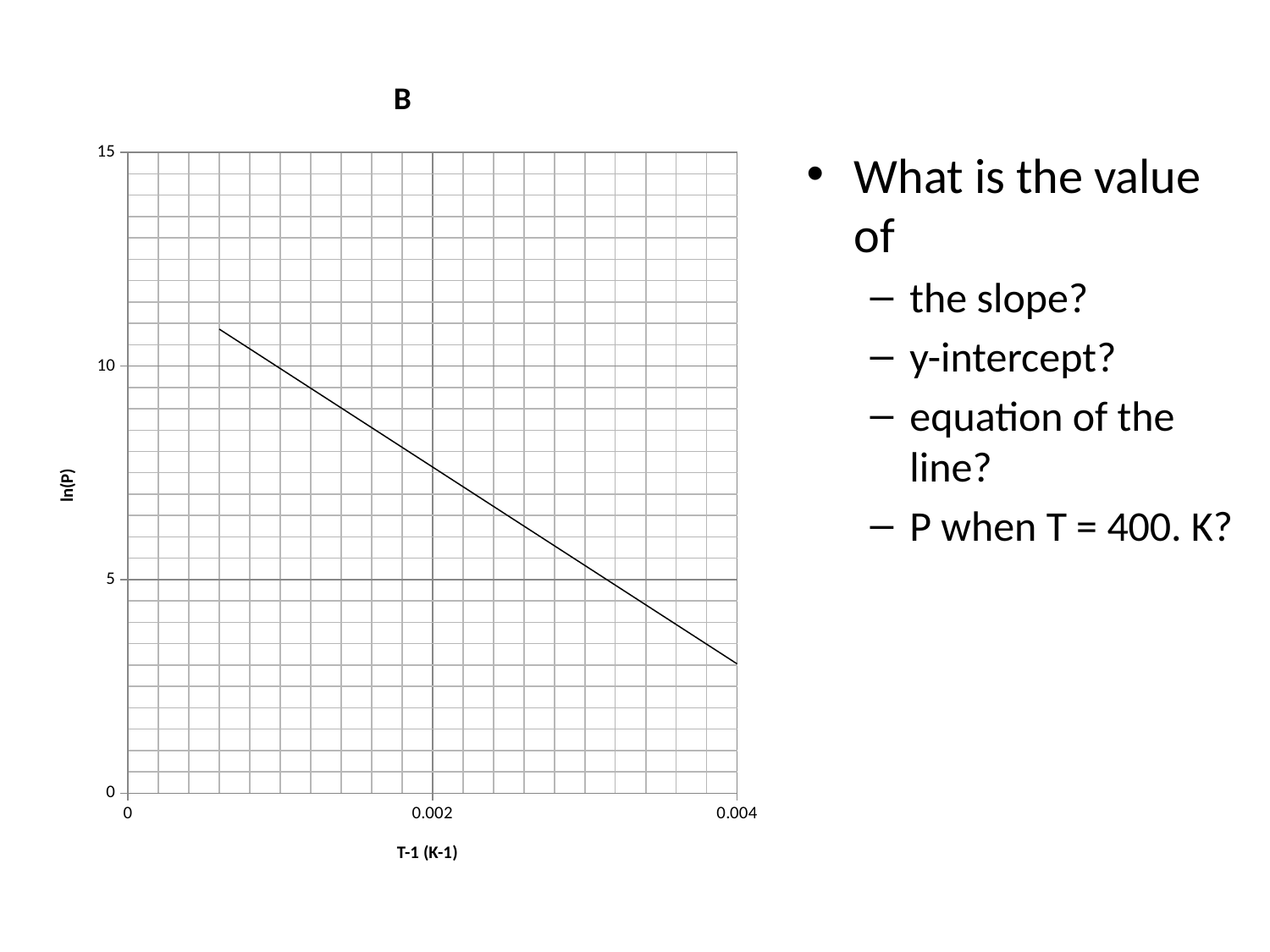
What is the highest value shown on the y axis of the chart? 15 Is the value of ln(P) at T-1 = 0.002 larger than the value at T-1 = 0.004? yes What is the title of the chart? B Is the value of ln(P) at T-1 = 0.003 greater or less than 10? less Does the plotted line rise or fall as the x-axis value increases? fall Is the value of ln(P) at the left end of the line greater or less than 10? greater Is the value of ln(P) at T-1 = 0.002 greater or less than 10? less What kind of chart is shown on the slide? line chart What is the label of the y axis of the chart? ln(P)